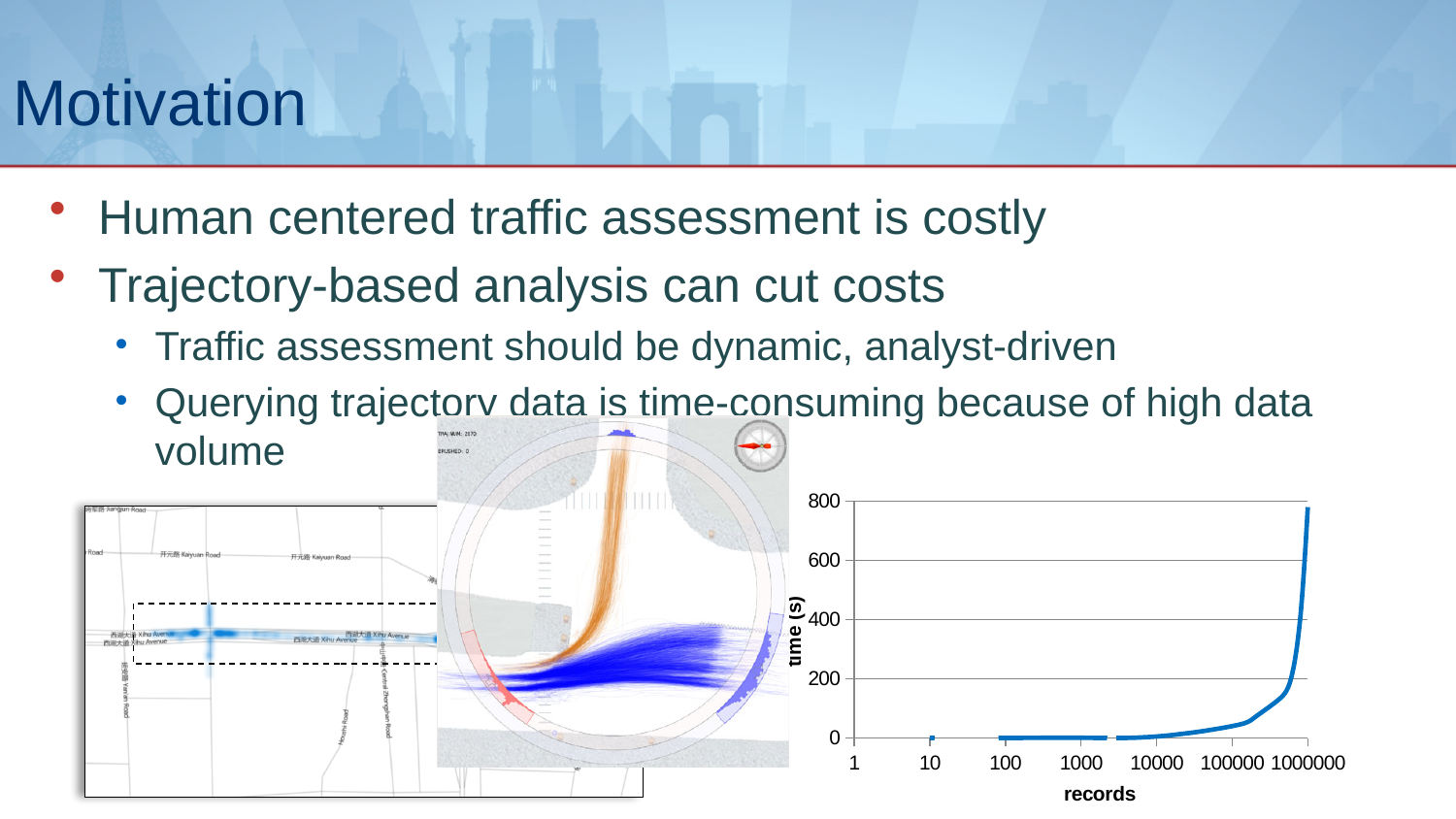
What kind of chart is shown on the right side of the slide? line chart In the chart on the right, what is the highest tick value shown on the y axis? 800 In the chart on the right, at which x-axis tick value does the line reach its highest time? 1000000 In the chart on the right, is the time value at 100000 records greater or less than 200? less In the chart on the right, what is the label of the x axis? records In the chart on the right, is the time value at 1000000 records greater or less than 600? greater In the chart on the right, is the time value at 1000 records greater or less than 200? less In the chart on the right, what is the label of the y axis? time (s) In the chart on the right, does the time rise or fall as the number of records increases along the x axis? rise In the chart on the right, how many tick labels are shown on the x axis? 7